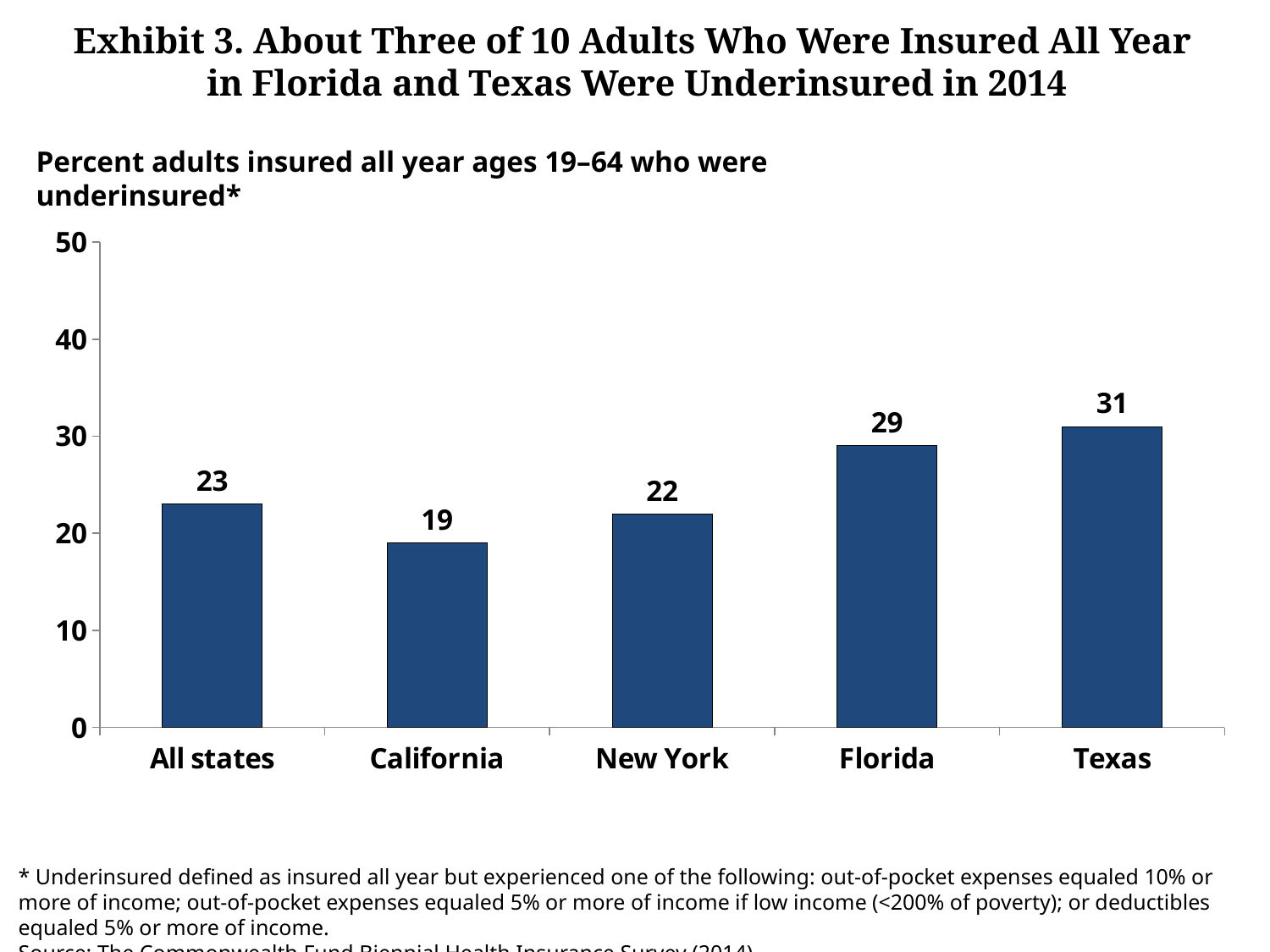
How many categories are shown on the x axis? 5 What kind of chart is shown on the slide? bar chart Which category has the highest value? Texas What is the value for Florida? 29 What is the value for California? 19 What is the difference between the values for Texas and California? 12 Which is larger, the value for New York or the value for All states? All states What is the maximum value shown on the y axis? 50 Is the value for Texas greater or less than 30? greater Which category has the lowest value? California What is the value for All states? 23 What is the difference between the values for Florida and New York? 7